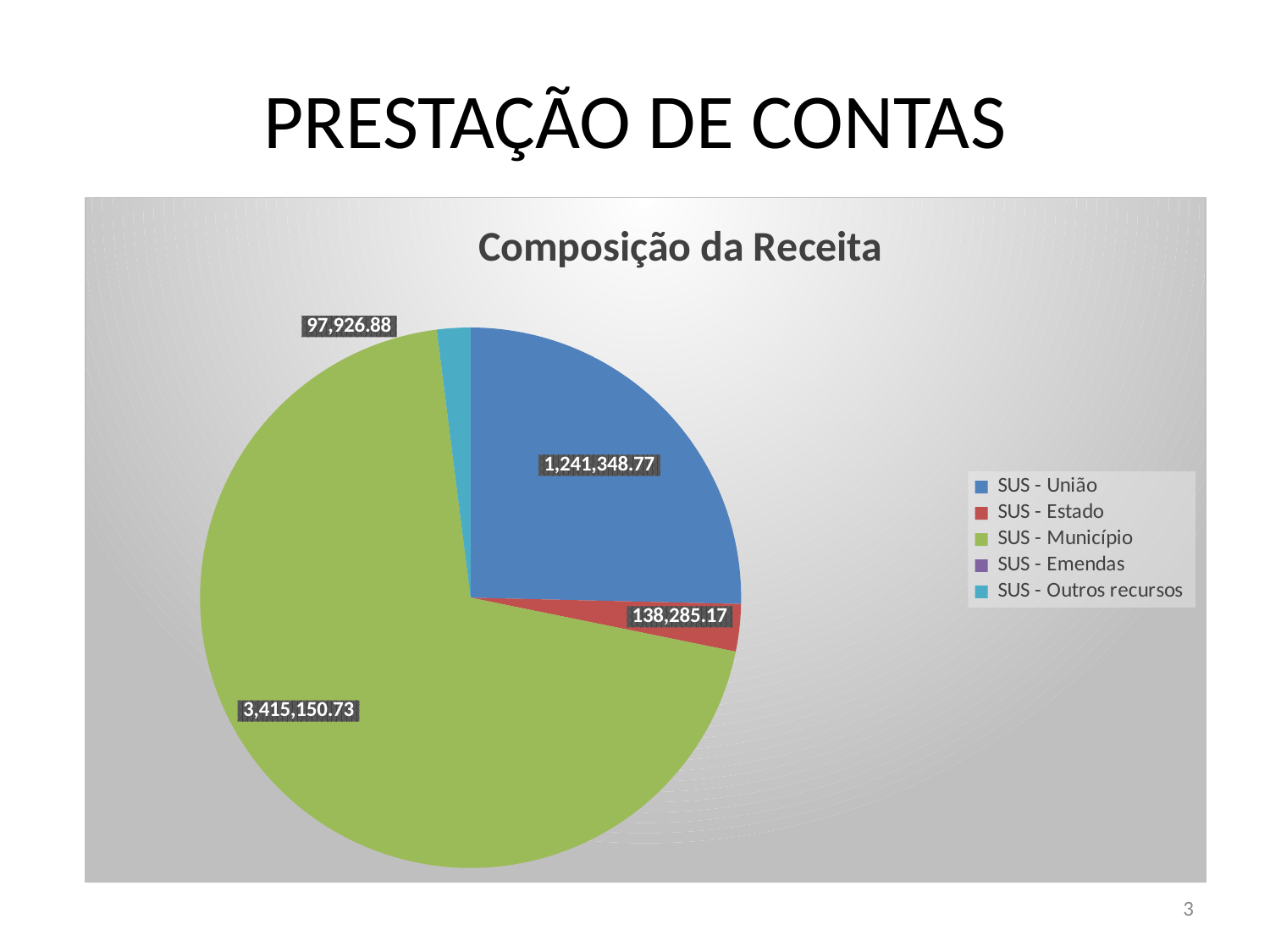
Which category has the largest slice in the Composição da Receita pie chart? SUS - Município What is the value shown for SUS - Estado in the pie chart? 138,285.17 Among the slices with data labels, which category has the smallest value? SUS - Outros recursos What is the title of the chart on the slide? Composição da Receita What kind of chart is shown on the slide? Pie chart What is the value shown for SUS - Outros recursos in the pie chart? 97,926.88 What is the difference between the values for SUS - Município and SUS - União? 2,173,801.96 Which is larger, the value for SUS - Estado or the value for SUS - Outros recursos? SUS - Estado How many categories does the legend of the pie chart list? 5 What is the value shown for SUS - Município in the Composição da Receita pie chart? 3,415,150.73 What is the value shown for SUS - União in the pie chart? 1,241,348.77 What is the difference between the values for SUS - União and SUS - Estado? 1,103,063.60